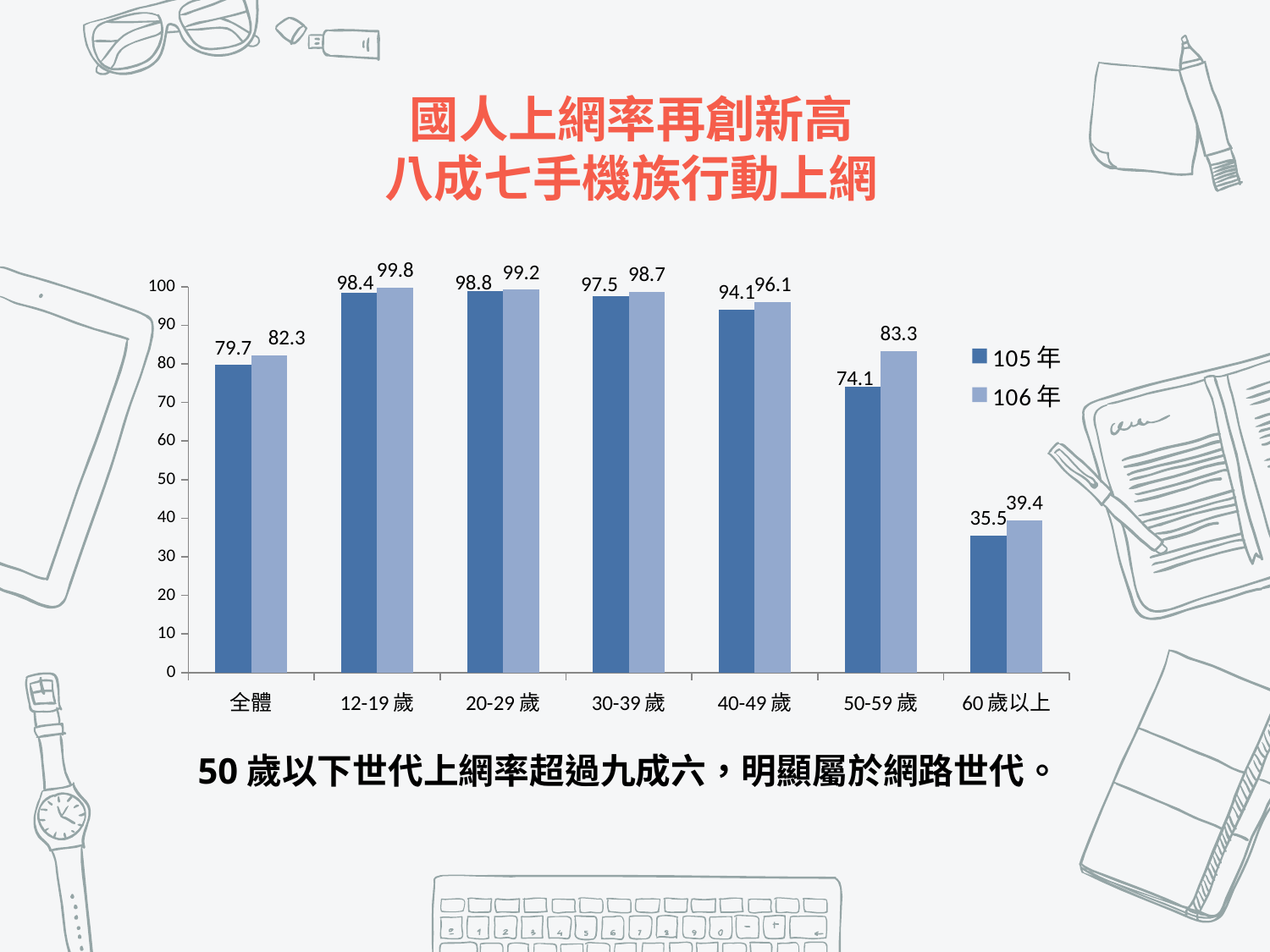
What is the value for 全體 in the 105 年 series? 79.7 What is the value for 50-59 歲 in the 106 年 series? 83.3 How many series does the legend list? 2 What is the difference between the 106 年 and 105 年 values for 50-59 歲? 9.2 Is the 106 年 value for 60 歲以上 greater or less than 50? less How many categories are shown on the x axis? 7 What is the value for 60 歲以上 in the 105 年 series? 35.5 What are the two series names listed in the legend? 105 年 and 106 年 Which is larger for 40-49 歲: the 105 年 value or the 106 年 value? 106 年 What kind of chart is shown on the slide? bar chart Which age category has the highest value in the 106 年 series? 12-19 歲 Which category has the lowest value in the 105 年 series? 60 歲以上